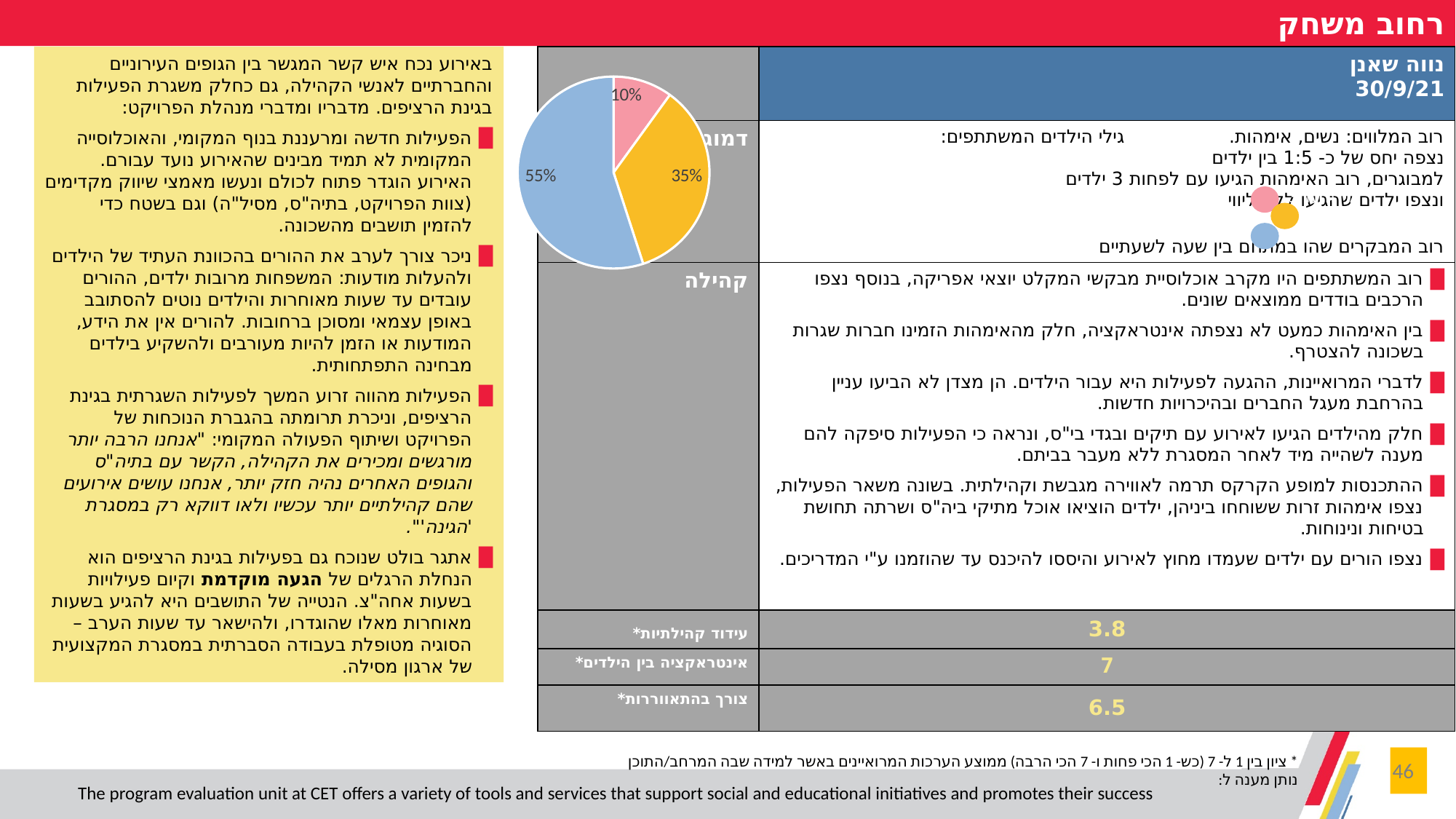
What percentage is shown on the pink slice of the pie chart? 10% Does the pie chart have a legend? no What is the difference in percentage points between the orange slice and the pink slice of the pie chart? 25 What is the smallest percentage shown in the pie chart? 10% What percentage is shown on the blue slice of the pie chart? 55% What kind of chart is shown on the slide? pie chart Which slice is larger in the pie chart, the blue slice or the orange slice? the blue slice What is the difference in percentage points between the largest slice and the second-largest slice of the pie chart? 20 What percentage is shown on the orange slice of the pie chart? 35% Which colour is the largest slice of the pie chart? blue How many slices does the pie chart have? 3 What is the largest percentage shown in the pie chart? 55%